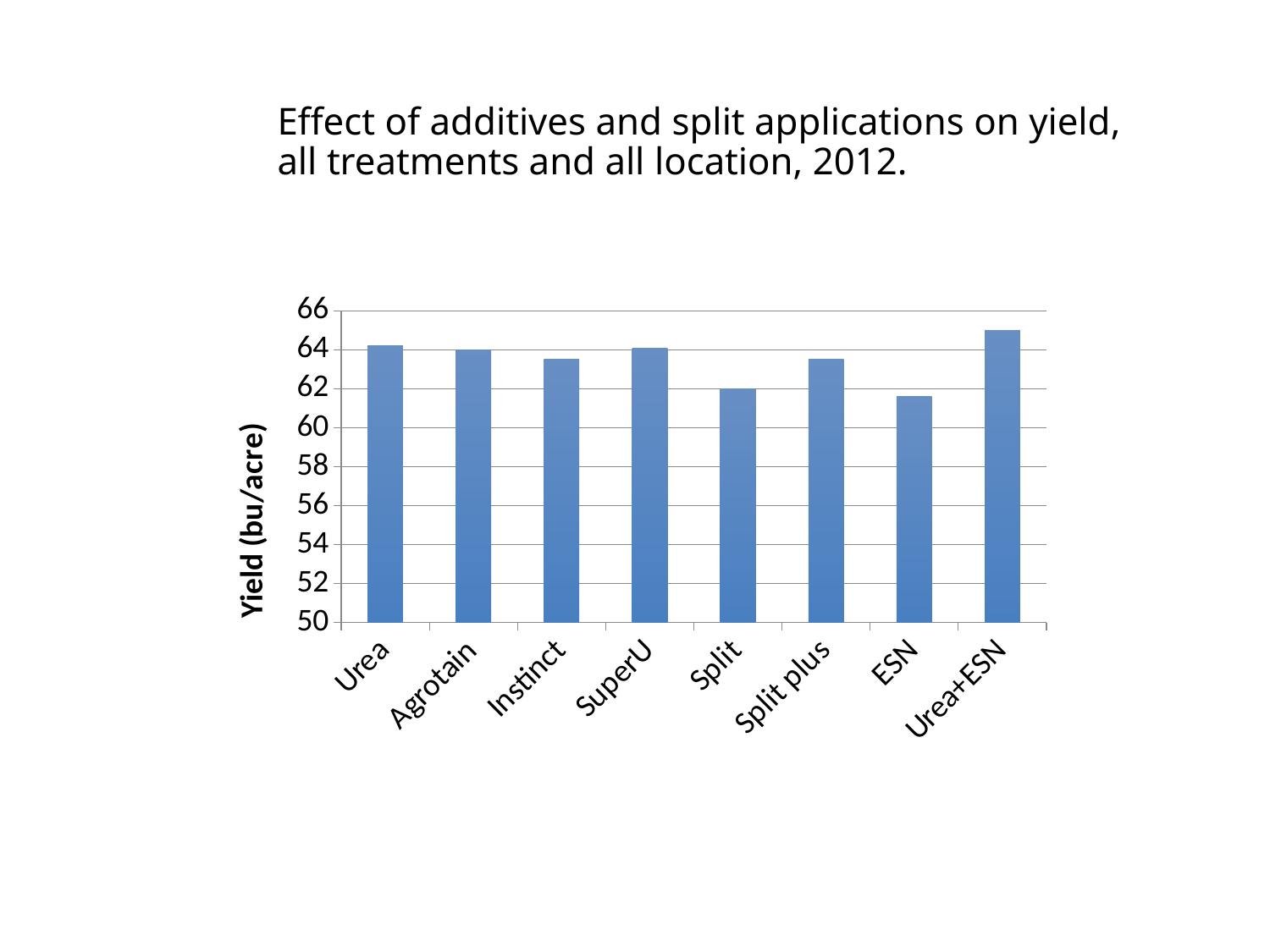
Which has the larger yield, Urea or Split? Urea What year is referred to in the slide title above the chart? 2012 Is the value for Split greater or less than 64? less How many treatments are shown on the x axis of the chart? 8 Which treatment has the lowest yield in the chart? ESN Is the value for Instinct greater or less than 64? less Which treatment has the highest yield in the chart? Urea+ESN Which has the larger yield, Urea+ESN or ESN? Urea+ESN Is the value for ESN greater or less than 60? greater What is the label of the y axis of the chart? Yield (bu/acre) What kind of chart is shown on the slide? bar chart